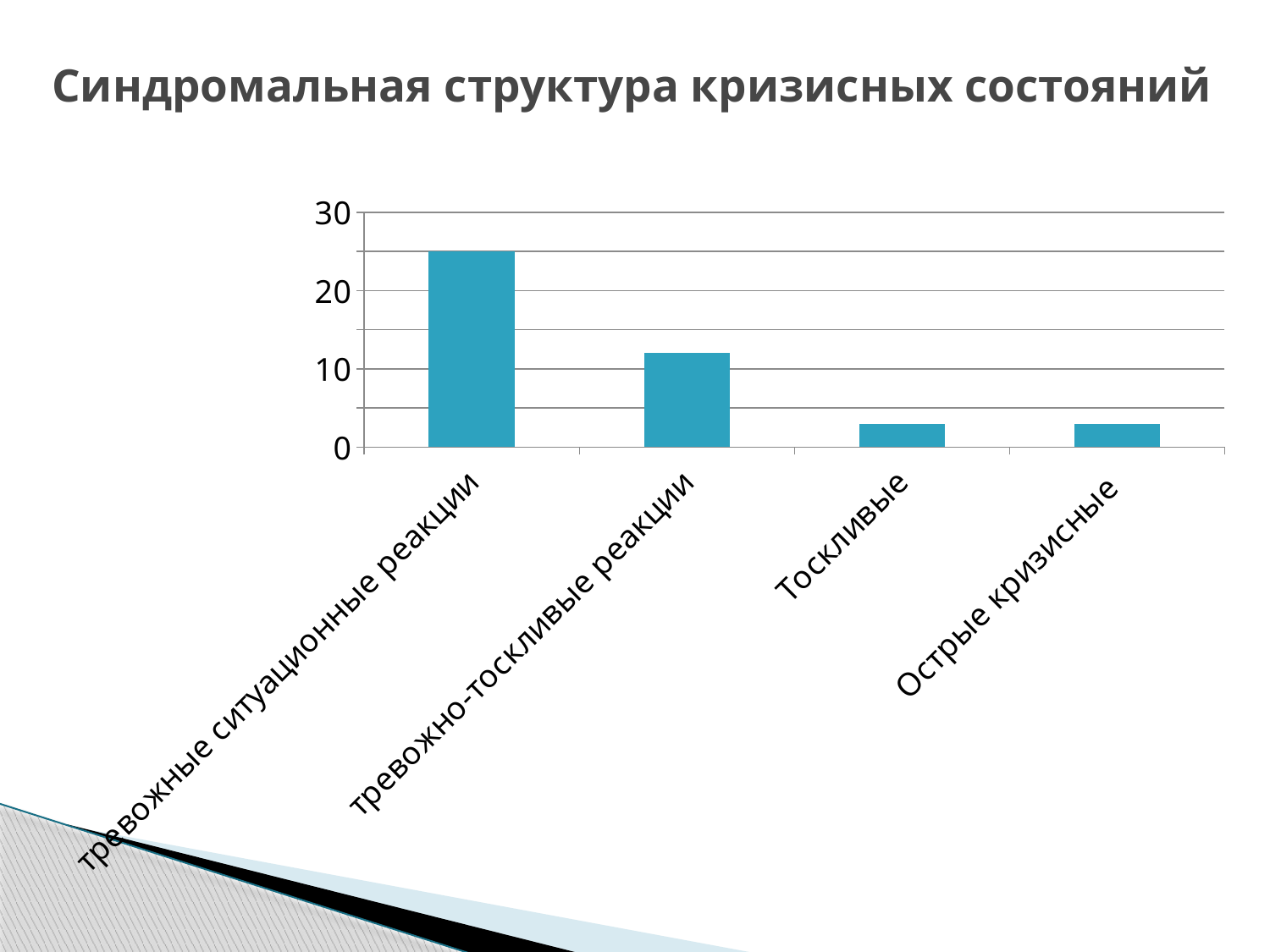
How many categories are plotted on the chart? 4 Is the value for Тоскливые greater or less than 10? less Which is larger: the value for тревожные ситуационные реакции or the value for тревожно-тоскливые реакции? тревожные ситуационные реакции Is the value for тревожно-тоскливые реакции greater or less than 10? greater Which category has the highest value? тревожные ситуационные реакции Which is larger: the value for тревожно-тоскливые реакции or the value for Тоскливые? тревожно-тоскливые реакции Is the value for Острые кризисные greater or less than 10? less What kind of chart is shown on the slide? bar chart What is the title of the slide? Синдромальная структура кризисных состояний Do the values generally rise or fall from left to right along the x axis? fall